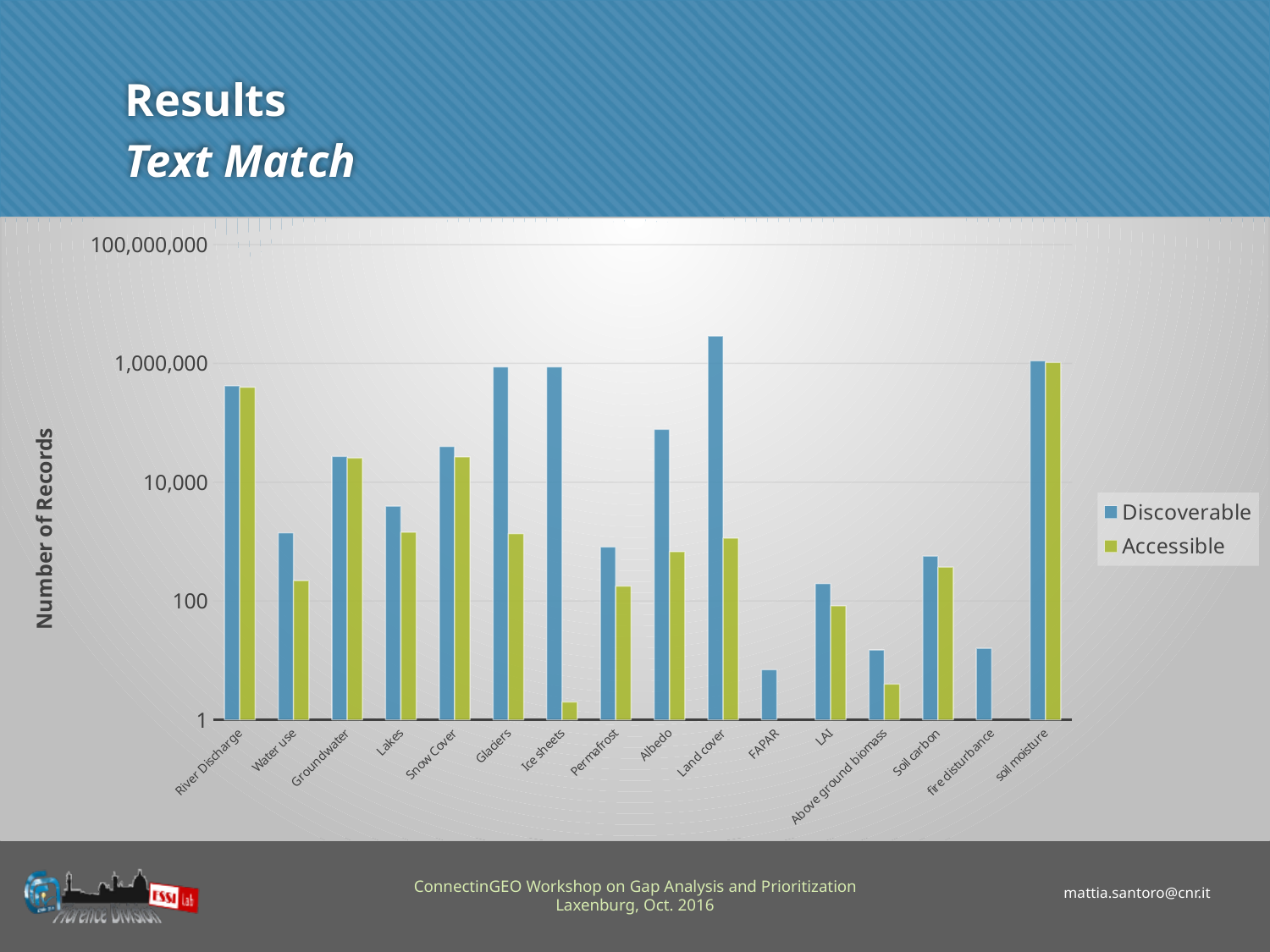
Is the Discoverable value for FAPAR greater or less than 100? less Is the Discoverable value for Water use greater or less than 100? greater Which has the larger Discoverable value, Groundwater or Lakes? Groundwater For Albedo, which series has the larger value, Discoverable or Accessible? Discoverable How many categories are shown on the x axis? 16 What kind of chart is shown on the slide? bar chart Which category has the lowest Discoverable value? FAPAR Is the Accessible value for Ice sheets greater or less than 100? less What is the title of the y axis? Number of Records Which category has the highest Discoverable value? Land cover How many series does the legend list? 2